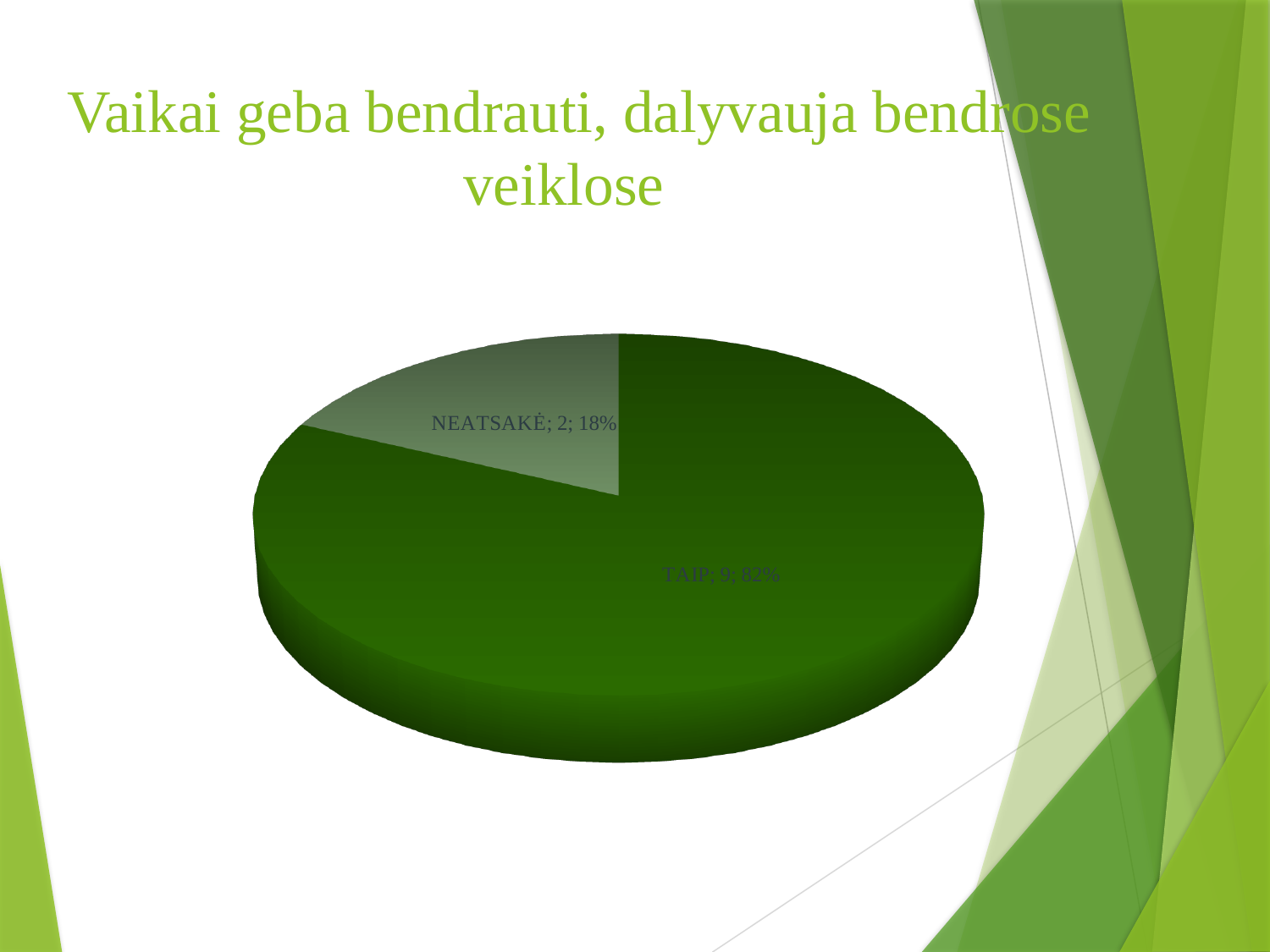
What is the count shown for the NEATSAKĖ slice? 2 What is the title of the slide containing the pie chart? Vaikai geba bendrauti, dalyvauja bendrose veiklose What is the total count across both slices of the pie chart? 11 Which slice is the largest in the pie chart? TAIP Which slice is the smallest in the pie chart? NEATSAKĖ Which slice has a larger count, TAIP or NEATSAKĖ? TAIP What is the count shown for the TAIP slice? 9 What percentage share does the TAIP slice have? 82% What percentage share does the NEATSAKĖ slice have? 18% What kind of chart is shown on the slide? pie chart How many slices does the pie chart have? 2 What is the difference in count between the TAIP and NEATSAKĖ slices? 7